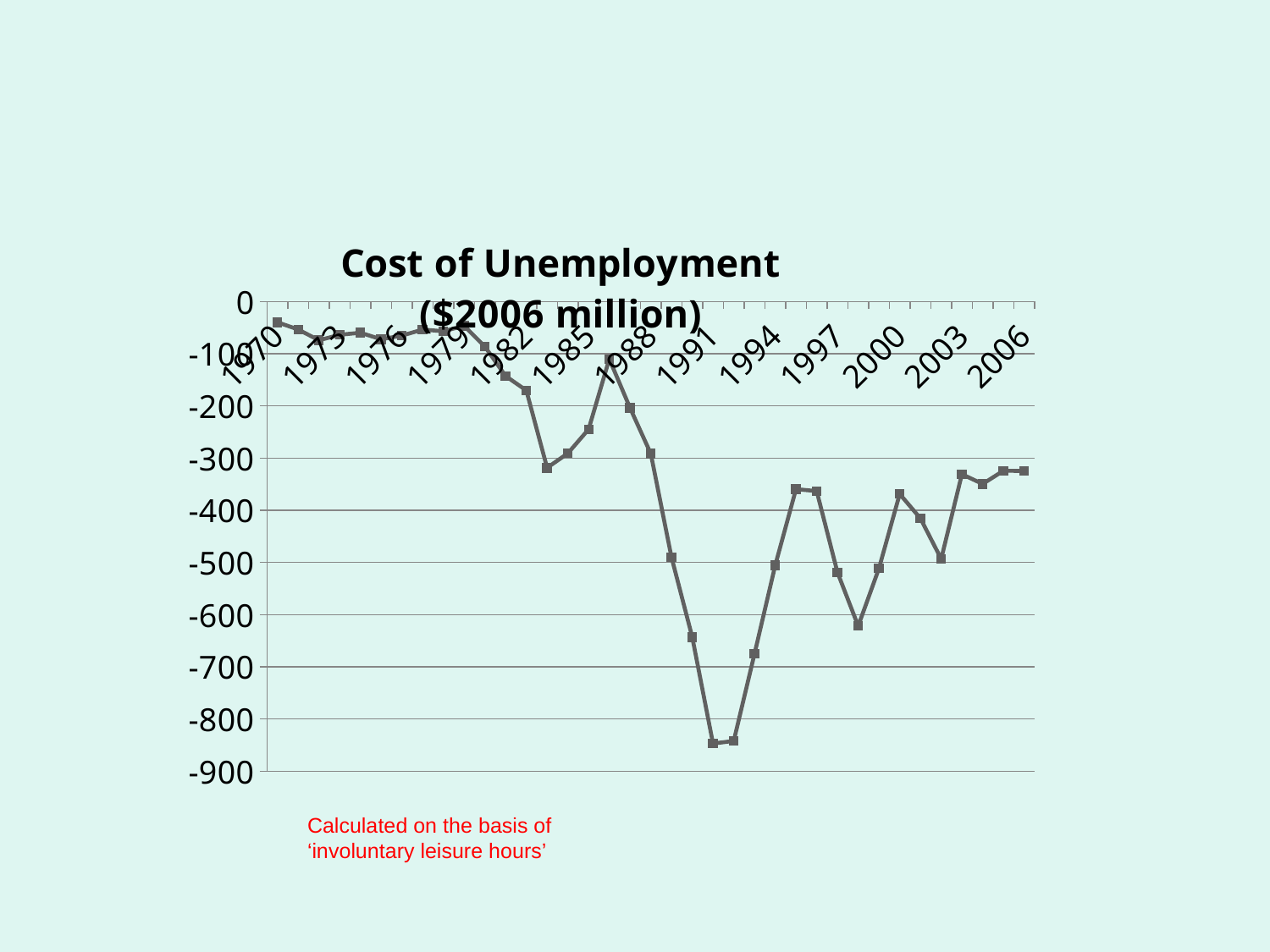
Is the lowest value on the chart greater or less than -800? less Is the value for 1970 greater or less than -100? greater What is the title of the chart? Cost of Unemployment ($2006 million) What type of chart is shown on the slide? line chart What is the lowest tick value shown on the vertical axis? -900 Is the value for 1970 greater or less than 0? less Which year has the higher value, 1970 or 2006? 1970 From 1970 to the lowest point of the line around 1990, do the values rise or fall? fall